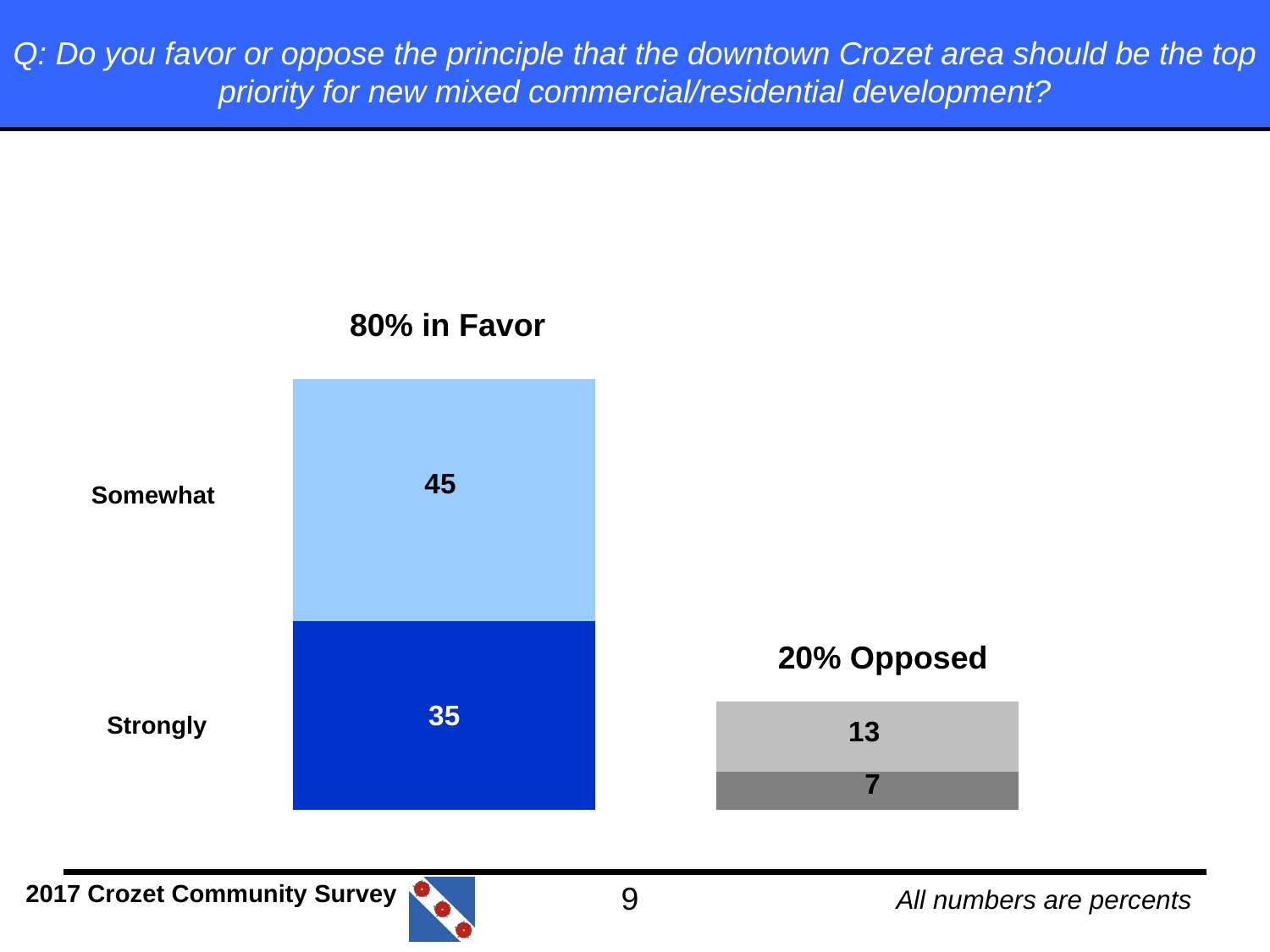
What is the value of the Strongly segment in the In Favor bar? 35 What is the value of the lighter top segment of the Opposed bar? 13 What is the difference between the In Favor total and the Opposed total? 60 What is the value of the darker bottom segment of the Opposed bar? 7 What is the total of the In Favor stacked bar? 80 Which bar is taller, In Favor or Opposed? In Favor Which is larger in the In Favor bar, the Somewhat segment or the Strongly segment? Somewhat What is the difference between the Somewhat and Strongly segments in the In Favor bar? 10 What kind of chart is shown on the slide? Stacked bar chart What percentage is shown as the label above the In Favor bar? 80% in Favor What is the total of the Opposed stacked bar? 20 What is the value of the Somewhat segment in the In Favor bar? 45